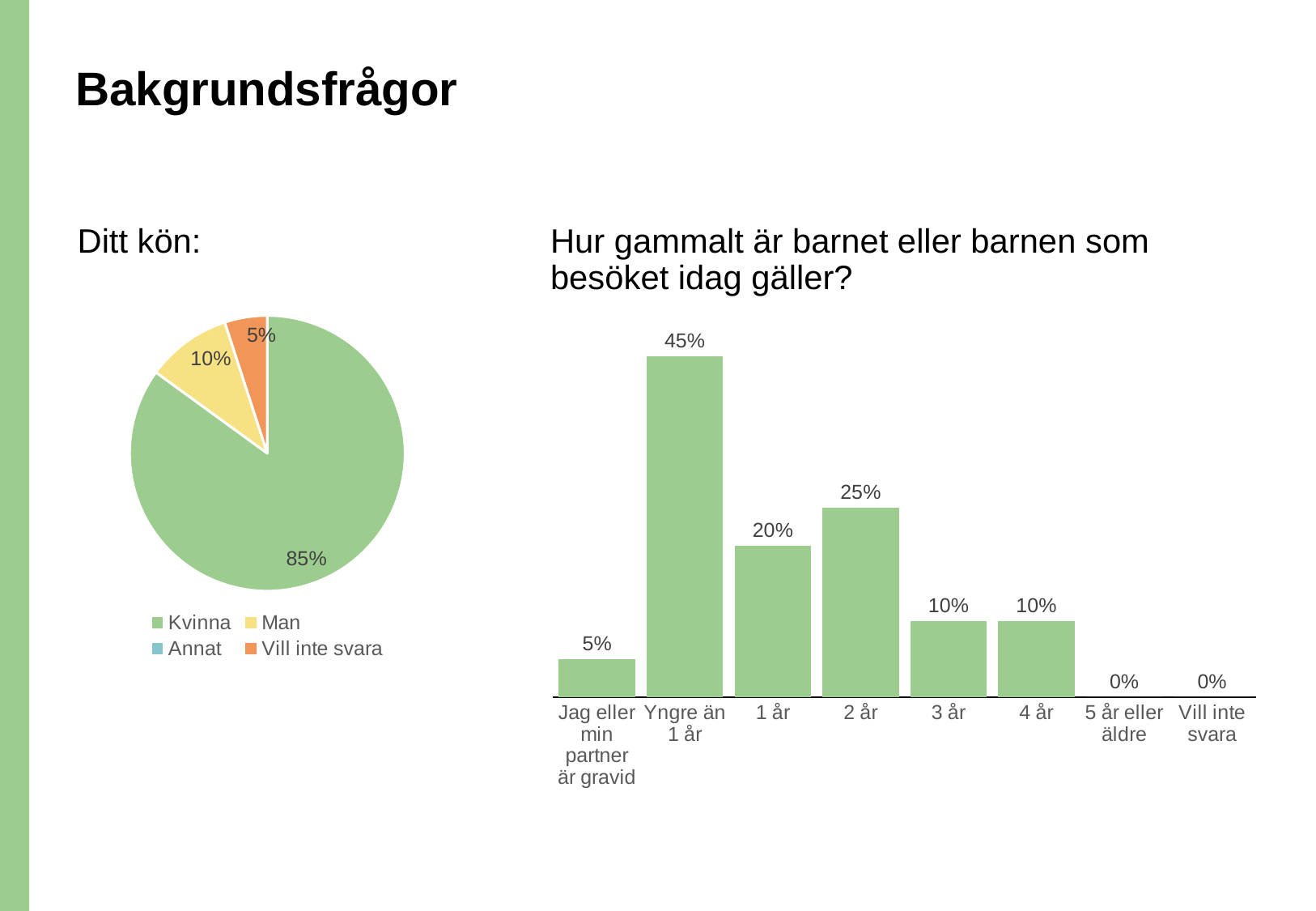
In the bar chart 'Hur gammalt är barnet eller barnen som besöket idag gäller?', what is the value for Yngre än 1 år? 45% In the pie chart 'Ditt kön:', how many entries does the legend list? 4 In the pie chart 'Ditt kön:', what share is Vill inte svara? 5% In the bar chart 'Hur gammalt är barnet eller barnen som besöket idag gäller?', which is larger, the value for 2 år or the value for 3 år? 2 år In the pie chart 'Ditt kön:', what share is Man? 10% In the bar chart 'Hur gammalt är barnet eller barnen som besöket idag gäller?', what is the difference between the values for Yngre än 1 år and 1 år? 25% In the bar chart 'Hur gammalt är barnet eller barnen som besöket idag gäller?', how many categories are shown on the x axis? 8 In the pie chart 'Ditt kön:', what share is Kvinna? 85% What kind of chart is the chart on the left, 'Ditt kön:'? Pie chart In the bar chart 'Hur gammalt är barnet eller barnen som besöket idag gäller?', which category has the highest value? Yngre än 1 år In the bar chart 'Hur gammalt är barnet eller barnen som besöket idag gäller?', what is the value for 2 år? 25% In the pie chart 'Ditt kön:', which category has the largest slice? Kvinna